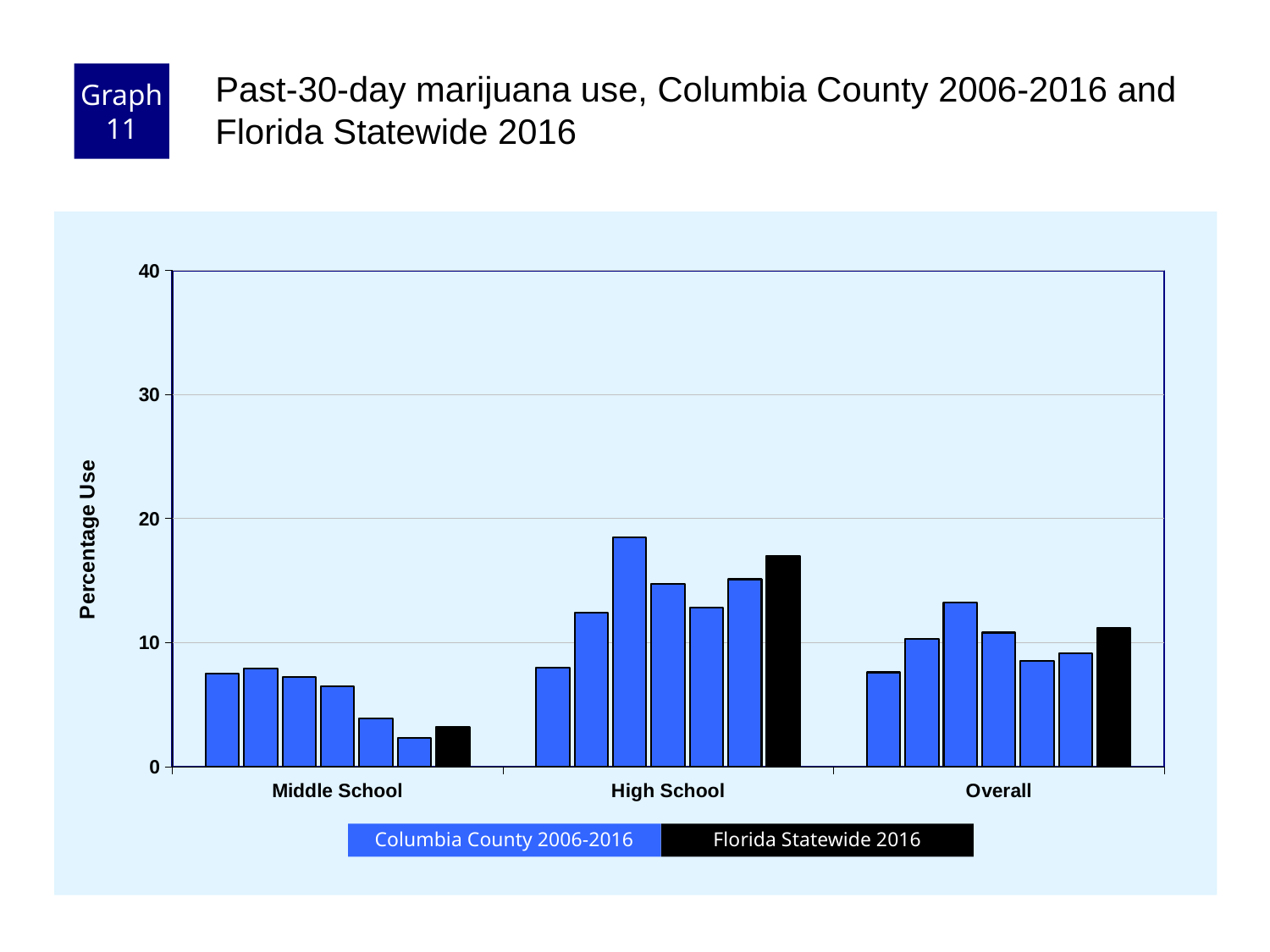
Which is larger: the Florida Statewide 2016 value for High School or for Middle School? High School Is the Florida Statewide 2016 value for Overall greater or less than 20? less Is the Florida Statewide 2016 value for Middle School greater or less than 10? less Is the Florida Statewide 2016 value for High School greater or less than 20? less Which category has the shortest bars overall? Middle School How many categories are shown on the x axis? 3 Which category has the tallest bars overall? High School How many series does the legend list? 2 What colour are the Florida Statewide 2016 bars? black What kind of chart is shown on the slide? bar chart What is the label on the y axis? Percentage Use